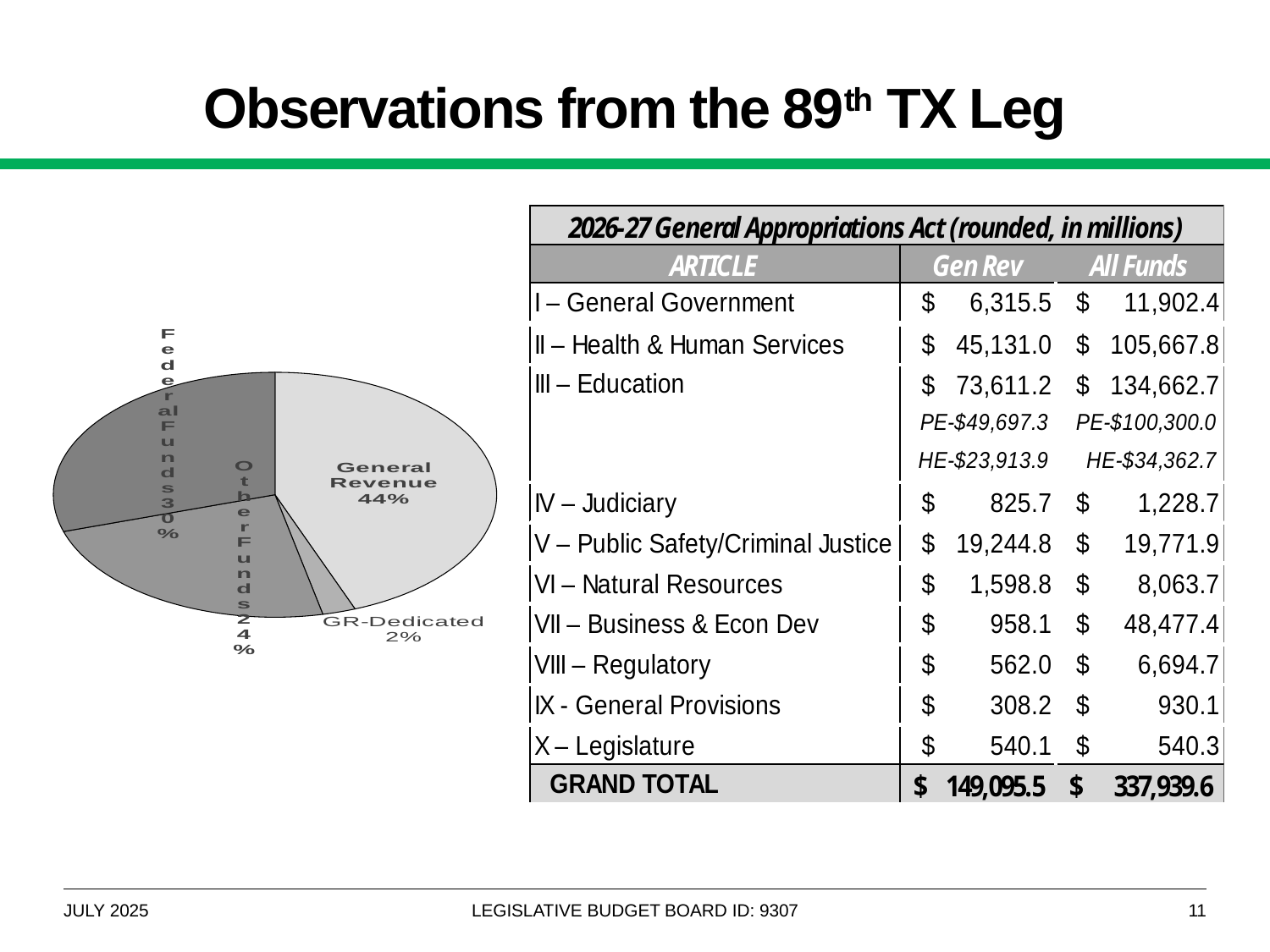
In the pie chart, what share does Other Funds have? 24% In the pie chart, what is the difference in percentage points between Other Funds and GR-Dedicated? 22 percentage points Which slice of the pie chart is the smallest? GR-Dedicated What kind of chart is shown on the left of the slide? pie chart How many slices does the pie chart have? 4 In the pie chart, is the share for General Revenue greater or less than 50%? less In the pie chart, what is the difference in percentage points between General Revenue and Federal Funds? 14 percentage points In the pie chart, what share does General Revenue have? 44% In the pie chart, what share does GR-Dedicated have? 2% Which slice of the pie chart is the largest? General Revenue In the pie chart, which is larger: Federal Funds or Other Funds? Federal Funds